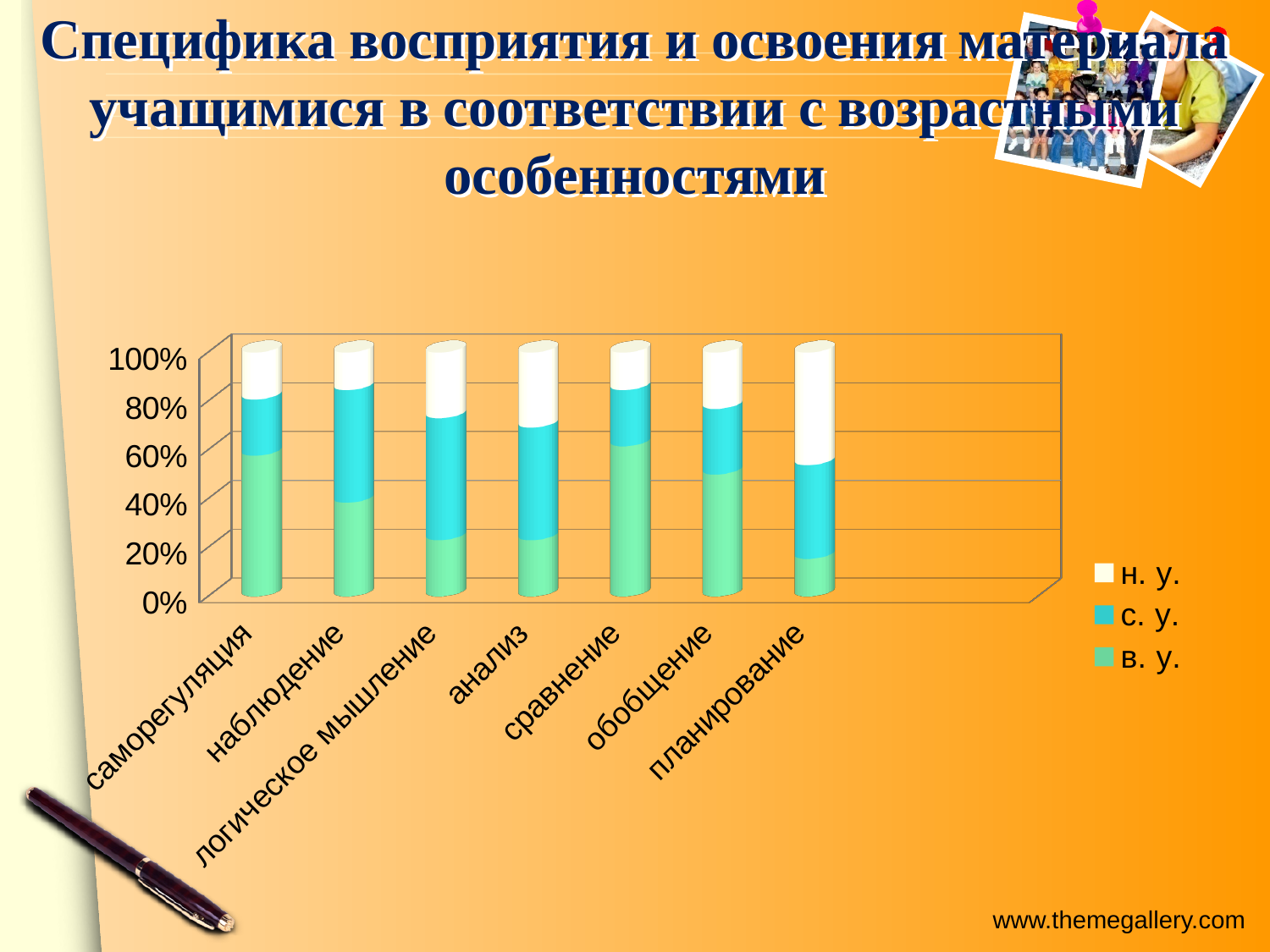
Is the в. у. value for обобщение greater or less than 40%? greater Which category has the highest value for the н. у. series? планирование Is the в. у. value for саморегуляция greater or less than 40%? greater Which category has the lowest value for the в. у. series? планирование What kind of chart is shown on the slide? stacked bar chart Which category has the larger в. у. value: саморегуляция or наблюдение? саморегуляция Which series is shown in green in the chart? в. у. Is the в. у. value for логическое мышление greater or less than 40%? less How many series does the chart legend list? 3 Which category has the larger н. у. value: планирование or саморегуляция? планирование How many categories are shown along the x axis of the chart? 7 Which category has the larger в. у. value: анализ or обобщение? обобщение